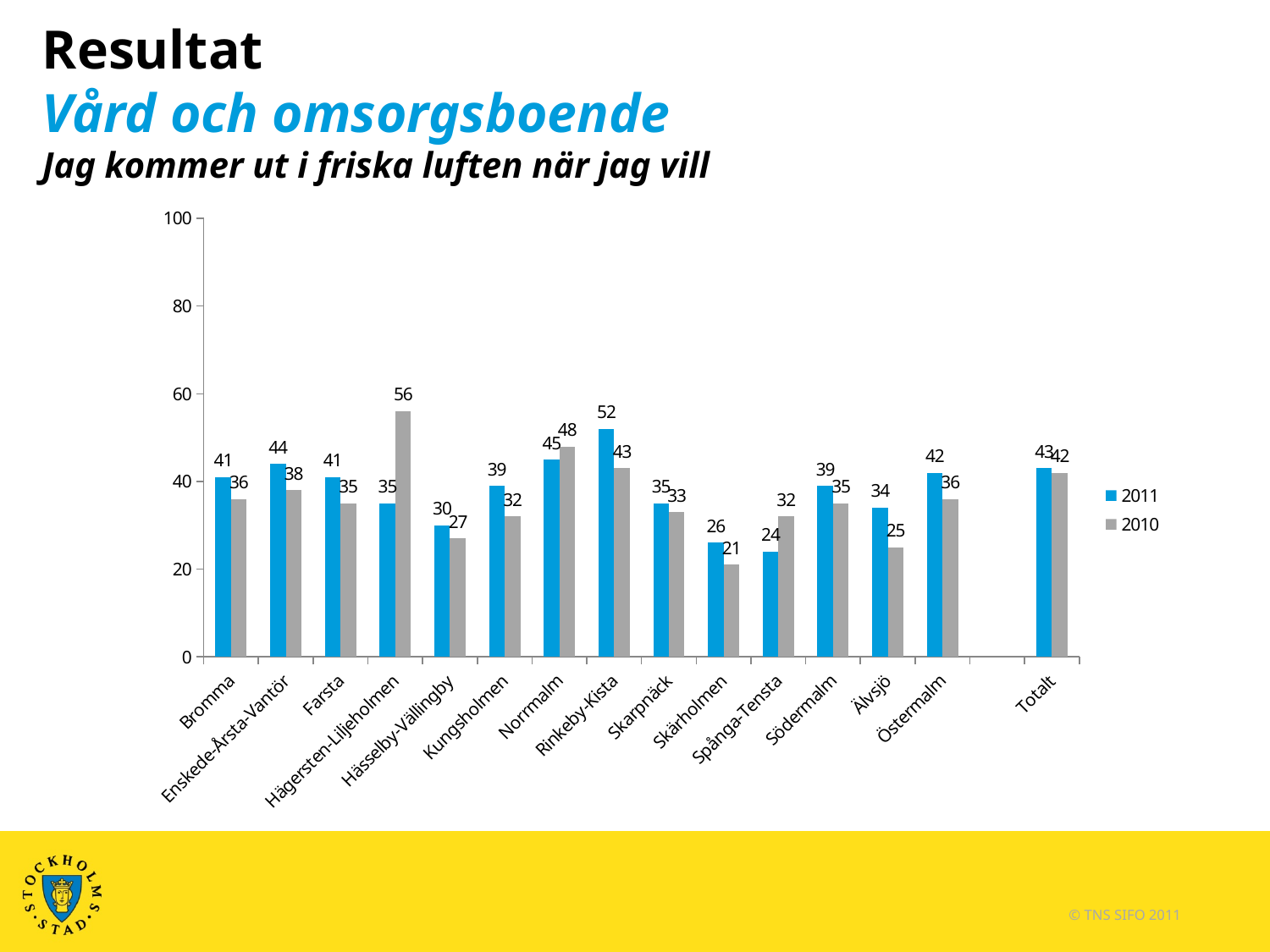
What is the 2011 value for Rinkeby-Kista? 52 What is the difference between the 2010 and 2011 values for Hägersten-Liljeholmen? 21 Which category has the highest 2011 value? Rinkeby-Kista What is the 2010 value for Hägersten-Liljeholmen? 56 Which is larger for Spånga-Tensta, the 2011 value or the 2010 value? 2010 How many series does the legend list? 2 Is the 2011 value for Norrmalm greater or less than 40? greater What kind of chart is shown on the slide? bar chart Which category has the lowest 2010 value? Skärholmen Which category has the lowest 2011 value? Spånga-Tensta How many categories are shown on the x axis? 15 What is the 2011 value for Totalt? 43